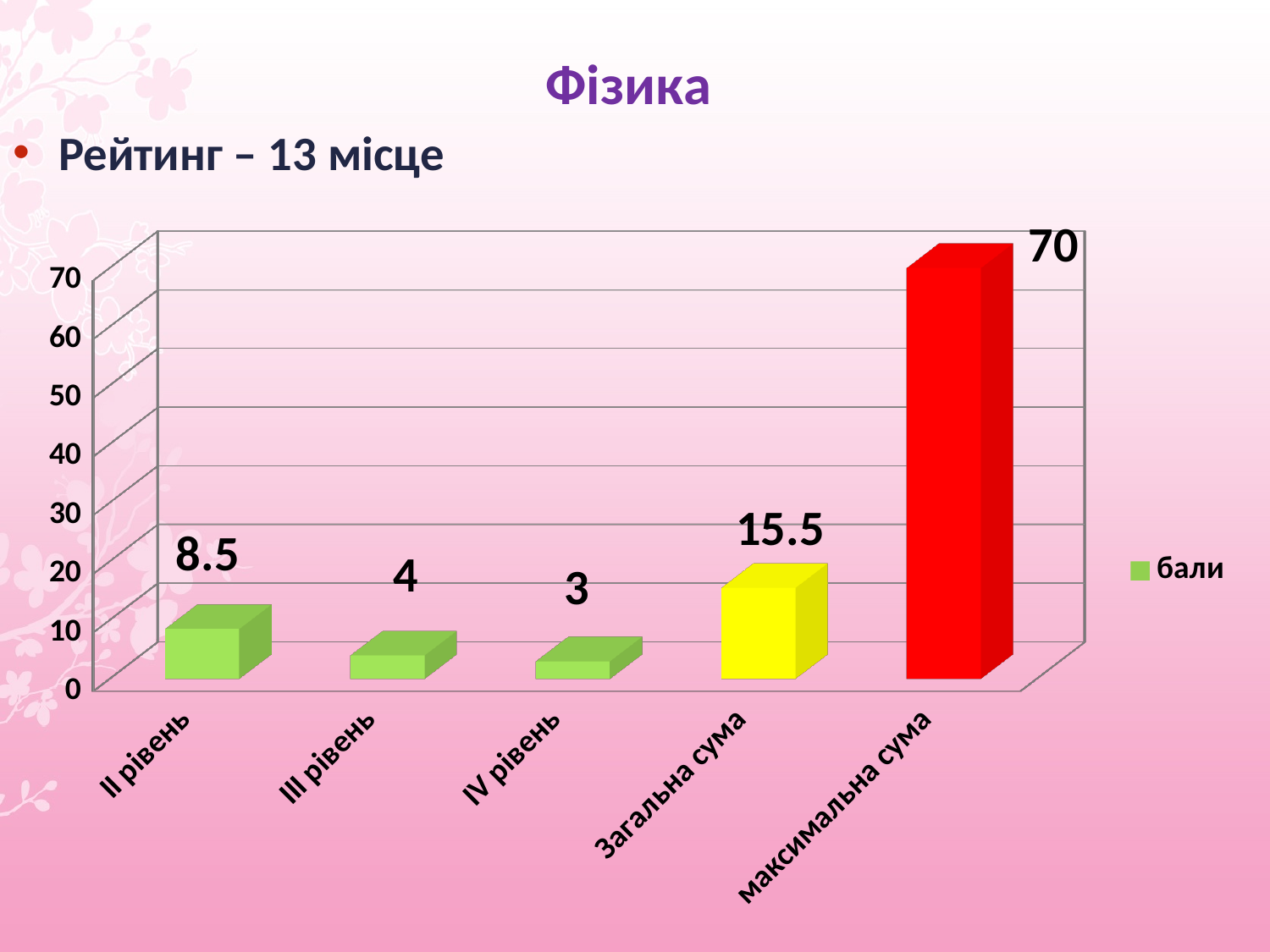
Which category has the lowest value? IV рівень What is the value for Загальна сума? 15.5 Which category has the highest value? максимальна сума What kind of chart is shown on the slide? bar chart What is the value for максимальна сума? 70 What is the value for IV рівень? 3 What is the difference between максимальна сума and Загальна сума? 54.5 How many categories are shown on the x axis? 5 Which is larger, the value for II рівень or the value for III рівень? II рівень What is the value for II рівень? 8.5 What series name does the legend list? бали What is the value for III рівень? 4